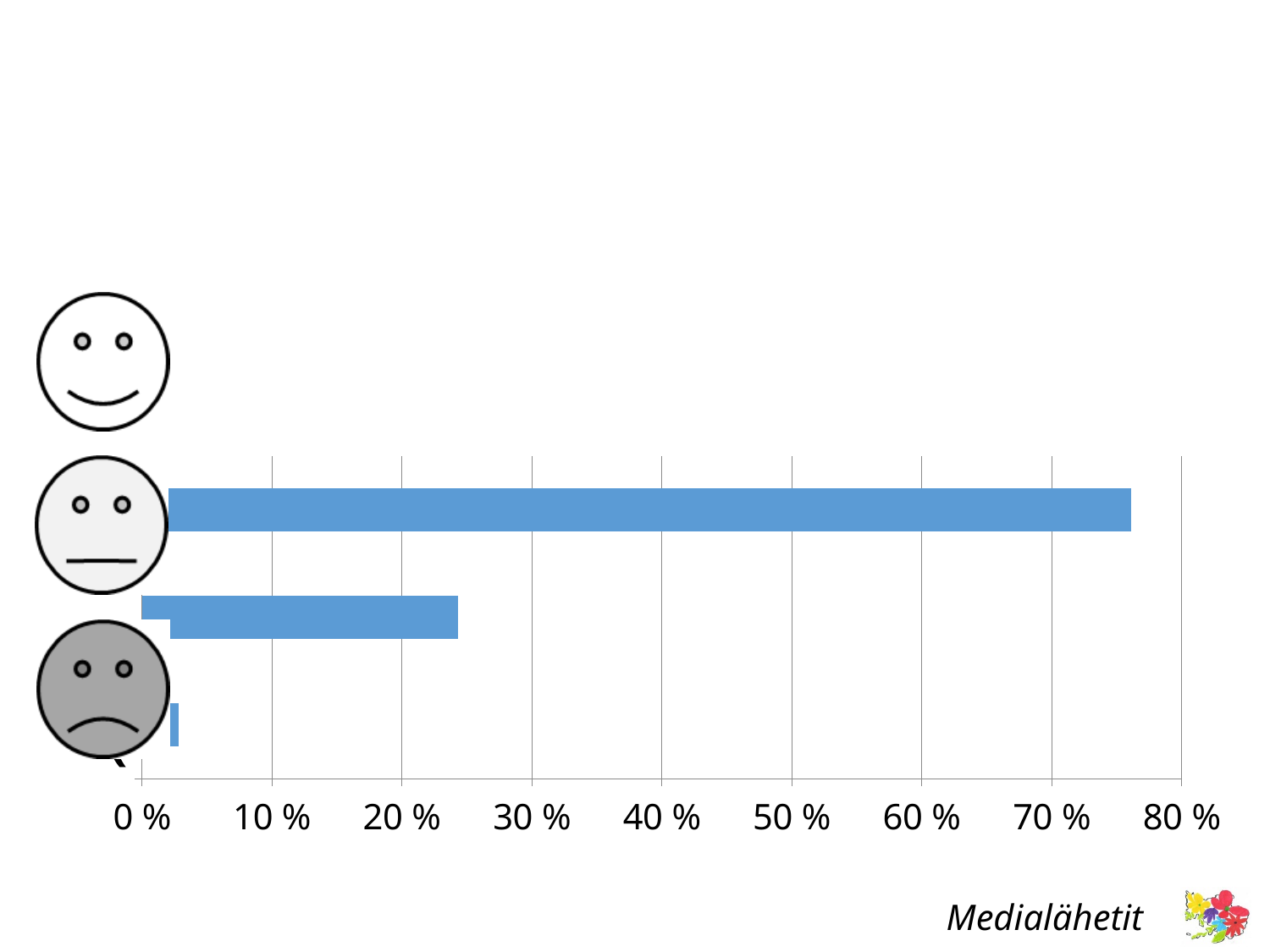
What is the highest value shown on the horizontal axis? 80 % Is the value of the bottom bar greater or less than 10 %? less Is the value of the top bar greater or less than 80 %? less Which bar is the shortest: the top, middle or bottom bar? bottom bar Is the value of the middle bar greater or less than 20 %? greater Which is larger, the middle bar or the bottom bar? middle bar How many bars are plotted in the chart? 3 Which bar is the longest: the top, middle or bottom bar? top bar What colour are the bars in the chart? blue What kind of chart is shown on the slide? bar chart